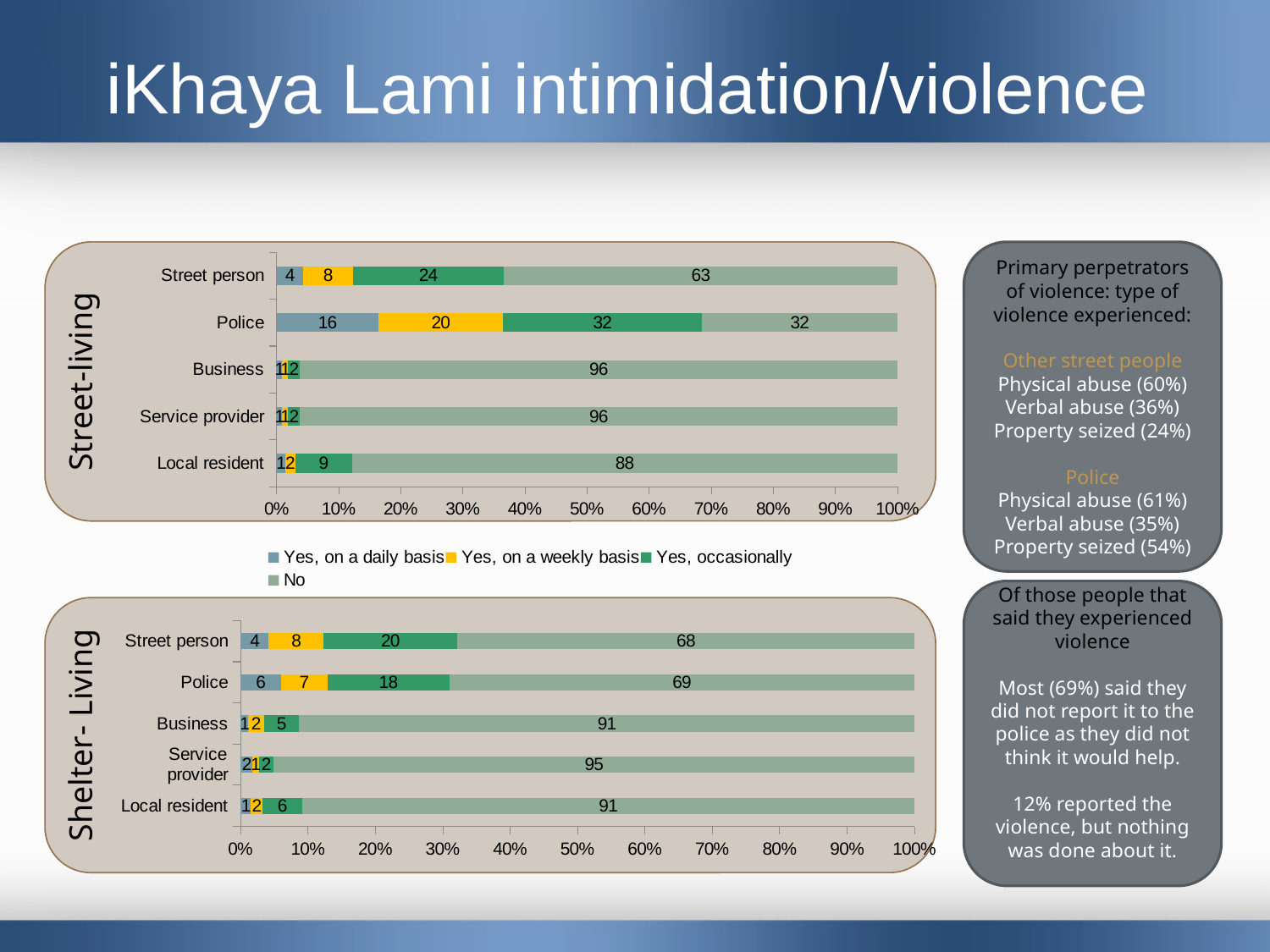
In the Street-living chart, which category has the largest 'Yes, on a daily basis' segment? Police In the Shelter- Living chart, which category has the smallest 'No' segment? Street person How many categories are shown on the y axis of the Shelter- Living chart? 5 What type of chart is the Street-living chart? Stacked bar chart Which legend entry is shown in yellow? Yes, on a weekly basis In the Street-living chart, what is the value of the 'No' segment for Police? 32 In the Street-living chart, what is the value of the 'Yes, occasionally' segment for Street person? 24 In the Street-living chart, what is the difference between the 'No' values for Business and Local resident? 8 In the Shelter- Living chart, is the 'Yes, occasionally' value larger for Street person or for Police? Street person In the Shelter- Living chart, what is the value of the 'No' segment for Service provider? 95 In the Shelter- Living chart, what is the value of the 'Yes, on a weekly basis' segment for Police? 7 How many series does the legend list? 4